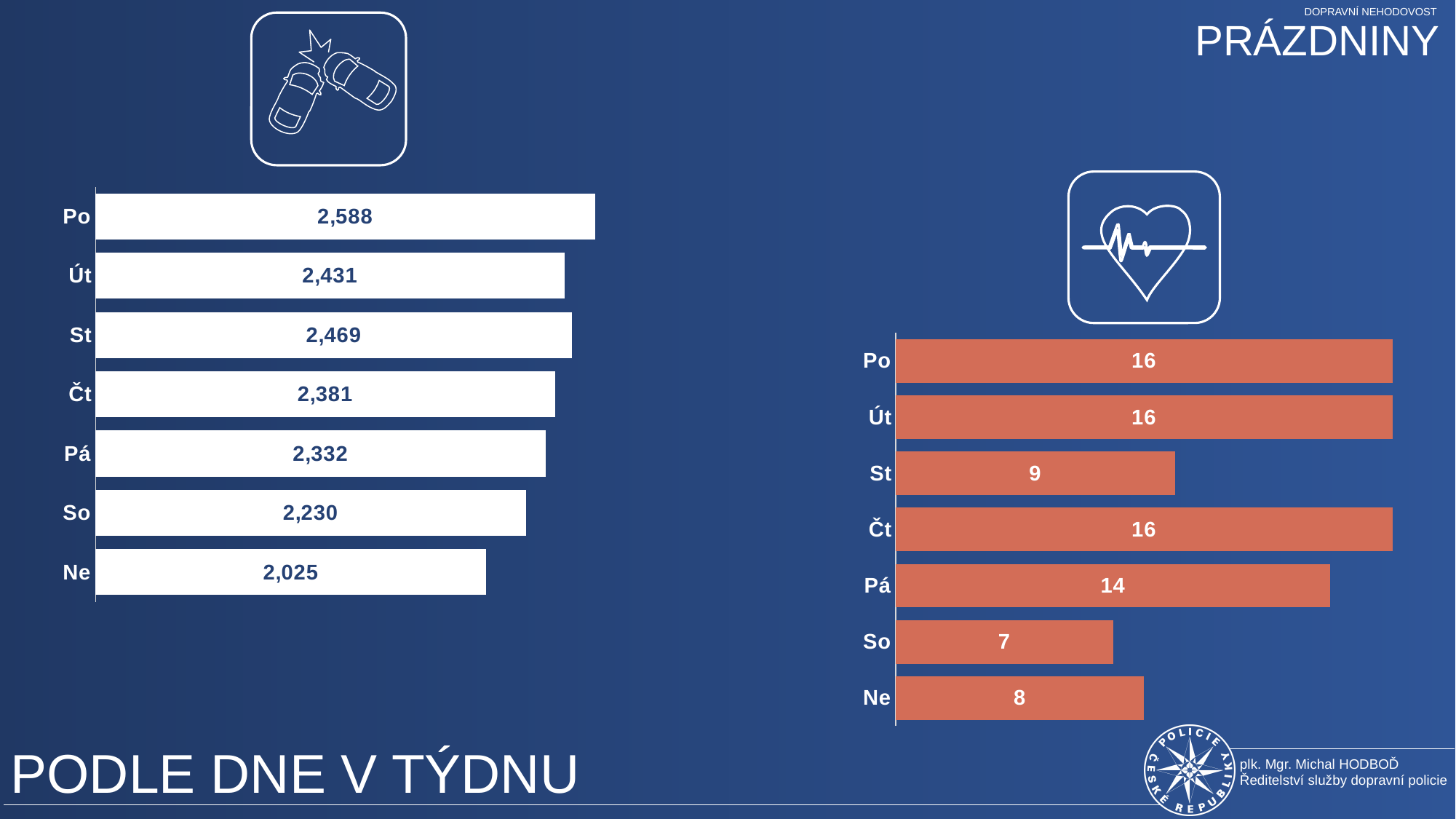
In the left chart, what is the value for Ne? 2,025 How many categories does the left chart show? 7 In the left chart, what is the difference between the values for Po and Ne? 563 In the right chart, what is the value for Pá? 14 In the left chart, what is the value for Po? 2,588 In the right chart, how many days have a value of 16? 3 In the left chart, which day has the highest value? Po In the right chart, which day has the lowest value? So In the left chart, which is larger, the value for Út or the value for St? St In the left chart, which day has the lowest value? Ne In the right chart, what is the difference between the values for Čt and St? 7 What type of chart is the right chart? Bar chart